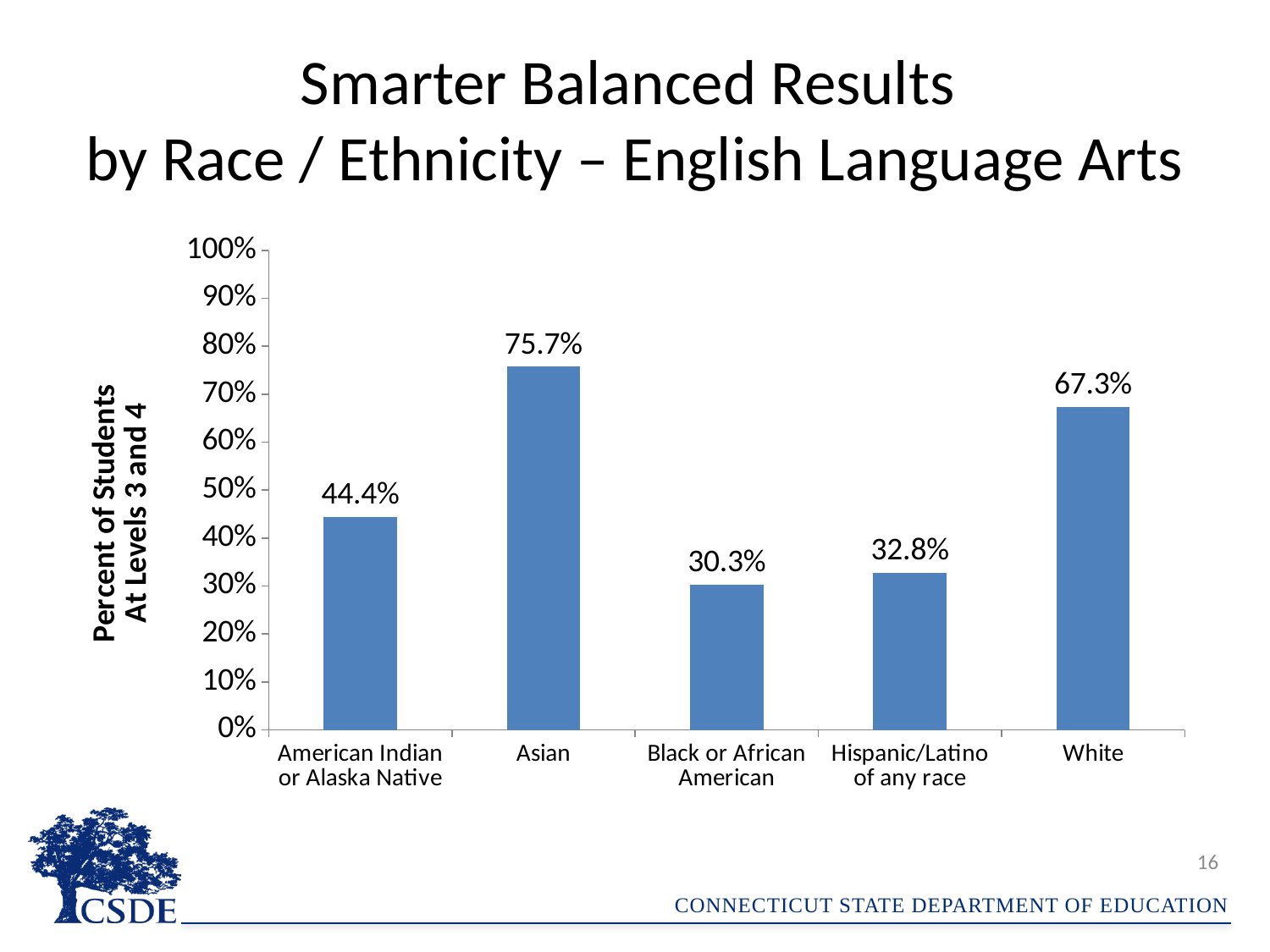
Which category has the lowest value? Black or African American What is the value for Black or African American? 30.3% What is the difference between the values for Asian and White? 8.4% What is the label of the y axis? Percent of Students At Levels 3 and 4 What is the difference between the values for Hispanic/Latino of any race and Black or African American? 2.5% What is the value for Hispanic/Latino of any race? 32.8% How many categories are shown on the x axis? 5 Which is larger, the value for White or the value for American Indian or Alaska Native? White Which category has the highest value? Asian What kind of chart is shown on the slide? Bar chart What is the value for American Indian or Alaska Native? 44.4% What is the value for Asian? 75.7%